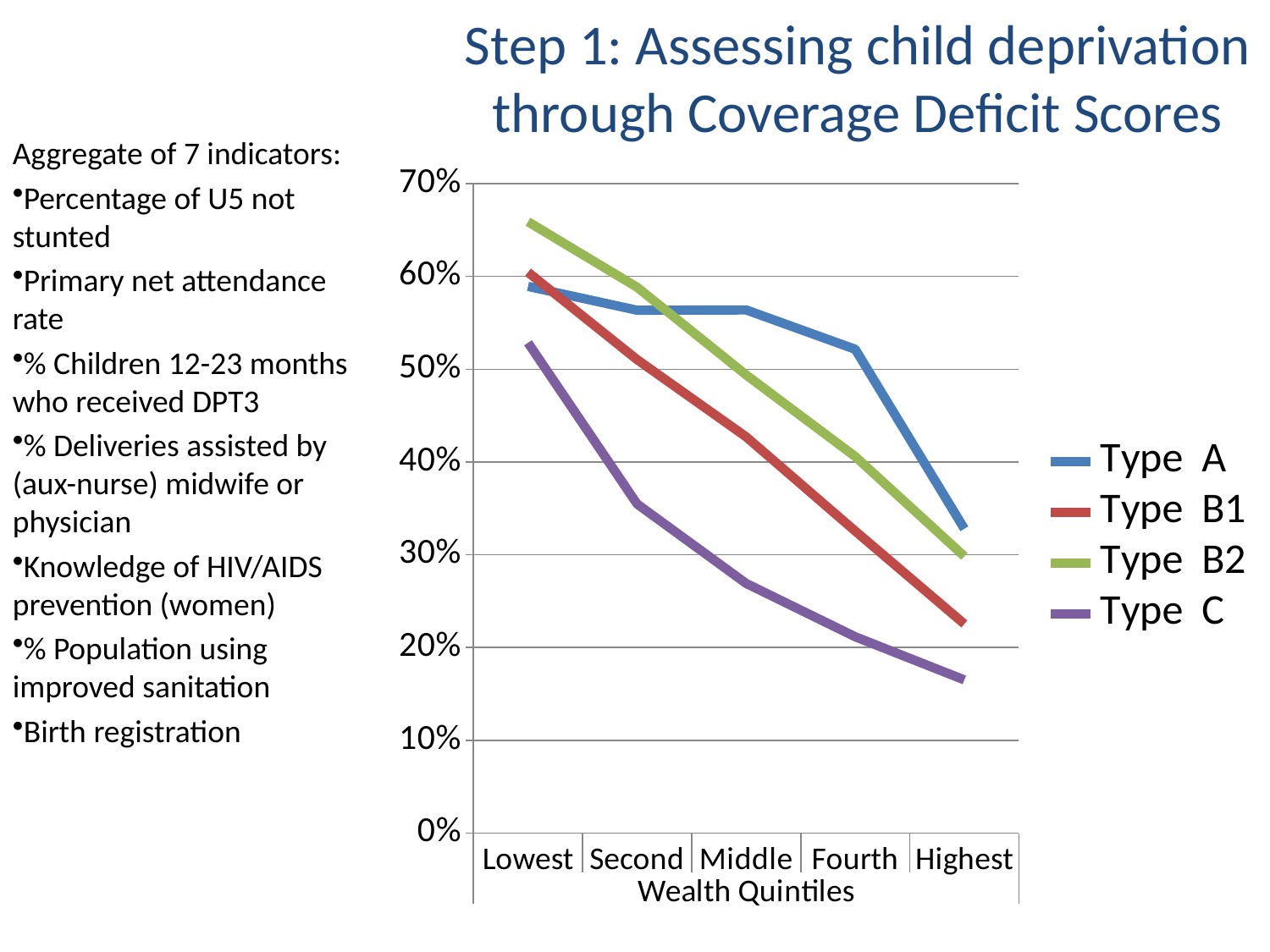
How many series does the legend list? 4 Which series has the highest value at the Lowest quintile? Type B2 Which series has the lowest value at the Middle quintile? Type C What is the title of the x axis? Wealth Quintiles How many wealth quintile categories are shown on the x axis? 5 Is the value for Type C at the Highest quintile greater or less than 20%? less Do the values for Type C rise or fall from the Lowest to the Highest wealth quintile? fall At the Highest quintile, which is larger: Type A or Type C? Type A Is the value for Type B2 at the Lowest quintile greater or less than 60%? greater Is the value for Type B1 at the Fourth quintile greater or less than 40%? less What kind of chart is shown on the slide? line chart